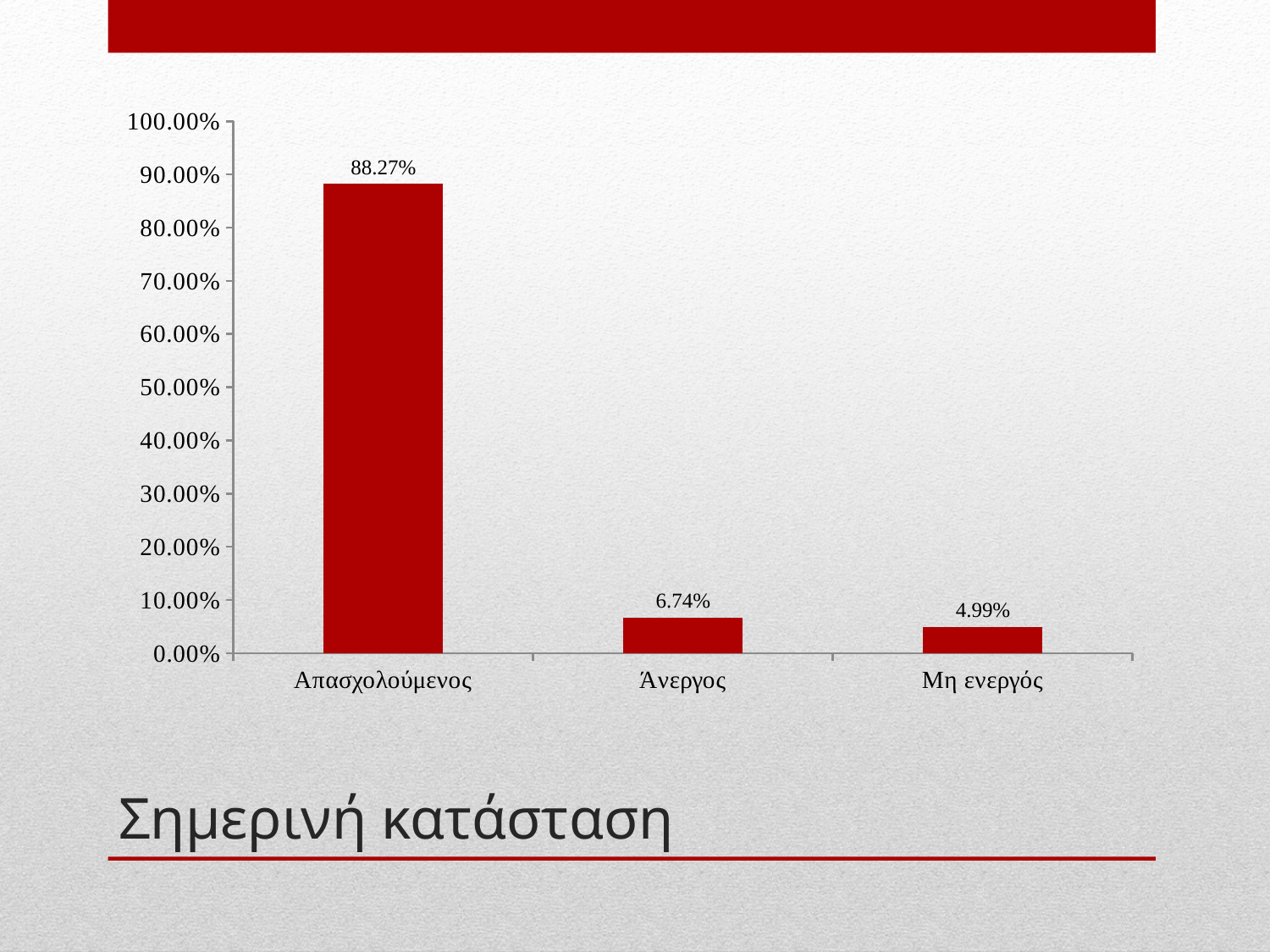
What is the value for Άνεργος? 6.74% What kind of chart is shown on the slide? bar chart How many categories are shown on the x axis? 3 What is the difference between the values for Άνεργος and Μη ενεργός? 1.75% What is the difference between the values for Απασχολούμενος and Άνεργος? 81.53% Which category has the lowest value? Μη ενεργός What is the title text shown below the chart on the slide? Σημερινή κατάσταση Which category has the highest value? Απασχολούμενος What is the value for Μη ενεργός? 4.99% Is the value for Απασχολούμενος greater or less than 80.00%? greater What is the value for Απασχολούμενος? 88.27% Which is larger, the value for Άνεργος or the value for Μη ενεργός? Άνεργος